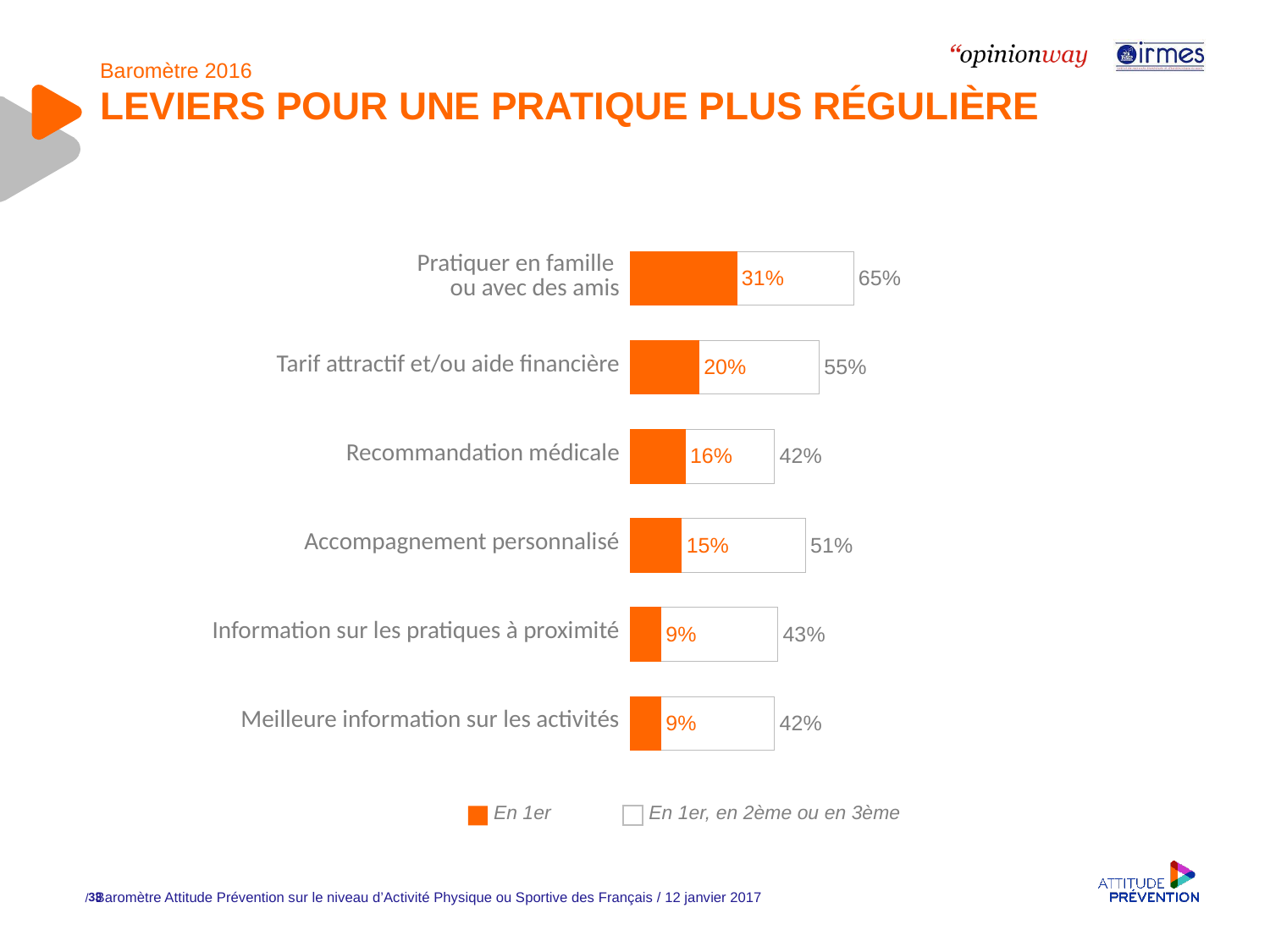
What is the 'En 1er' value for 'Pratiquer en famille ou avec des amis'? 31% How many series does the legend list? 2 What is the 'En 1er, en 2ème ou en 3ème' value for 'Tarif attractif et/ou aide financière'? 55% What is the difference between the 'En 1er' values for 'Pratiquer en famille ou avec des amis' and 'Tarif attractif et/ou aide financière'? 11 percentage points What kind of chart is shown on the slide? Bar chart Which category has the lowest 'En 1er, en 2ème ou en 3ème' value? Recommandation médicale and Meilleure information sur les activités (42%) Which category has the highest 'En 1er' value? Pratiquer en famille ou avec des amis How many categories are shown in the chart? 6 What is the 'En 1er' value for 'Accompagnement personnalisé'? 15% Which is larger: the 'En 1er' value for 'Recommandation médicale' or for 'Accompagnement personnalisé'? Recommandation médicale What is the difference between the 'En 1er, en 2ème ou en 3ème' values for 'Accompagnement personnalisé' and 'Recommandation médicale'? 9 percentage points What is the 'En 1er, en 2ème ou en 3ème' value for 'Information sur les pratiques à proximité'? 43%